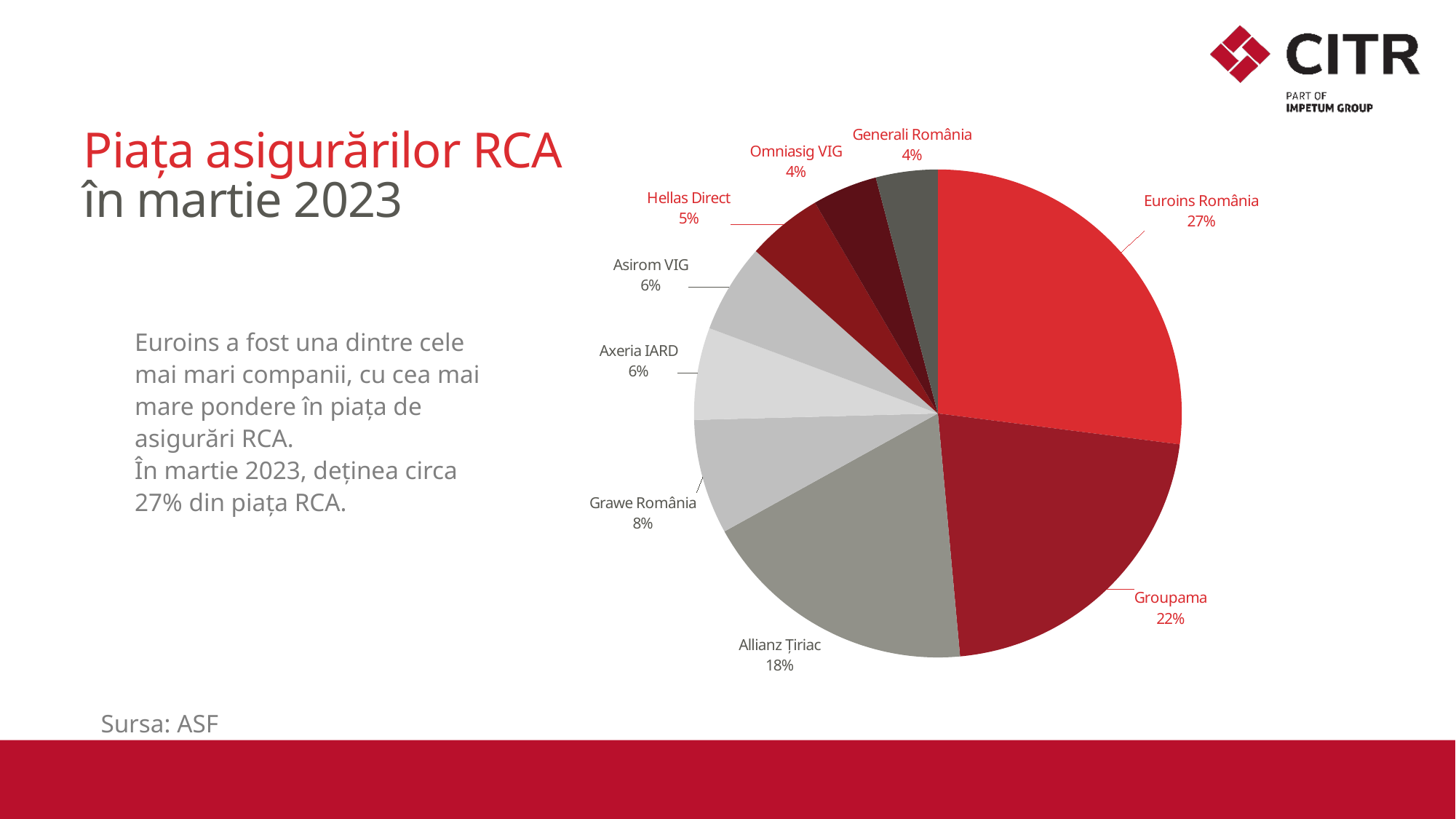
Which has a larger share, Allianz Țiriac or Grawe România? Allianz Țiriac What share does Groupama hold in the pie chart? 22% What is the combined share of Euroins România, Groupama and Allianz Țiriac? 67% What kind of chart is shown on the slide? Pie chart How many companies are shown as slices in the pie chart? 9 What is the difference in market share between Euroins România and Groupama? 5% What is the title of the slide containing the pie chart? Piața asigurărilor RCA în martie 2023 What share does Allianz Țiriac hold in the pie chart? 18% Which company has the largest slice of the pie chart? Euroins România What share of the RCA market does Euroins România hold in the pie chart? 27% What share does Hellas Direct hold in the pie chart? 5% What share does Grawe România hold in the pie chart? 8%